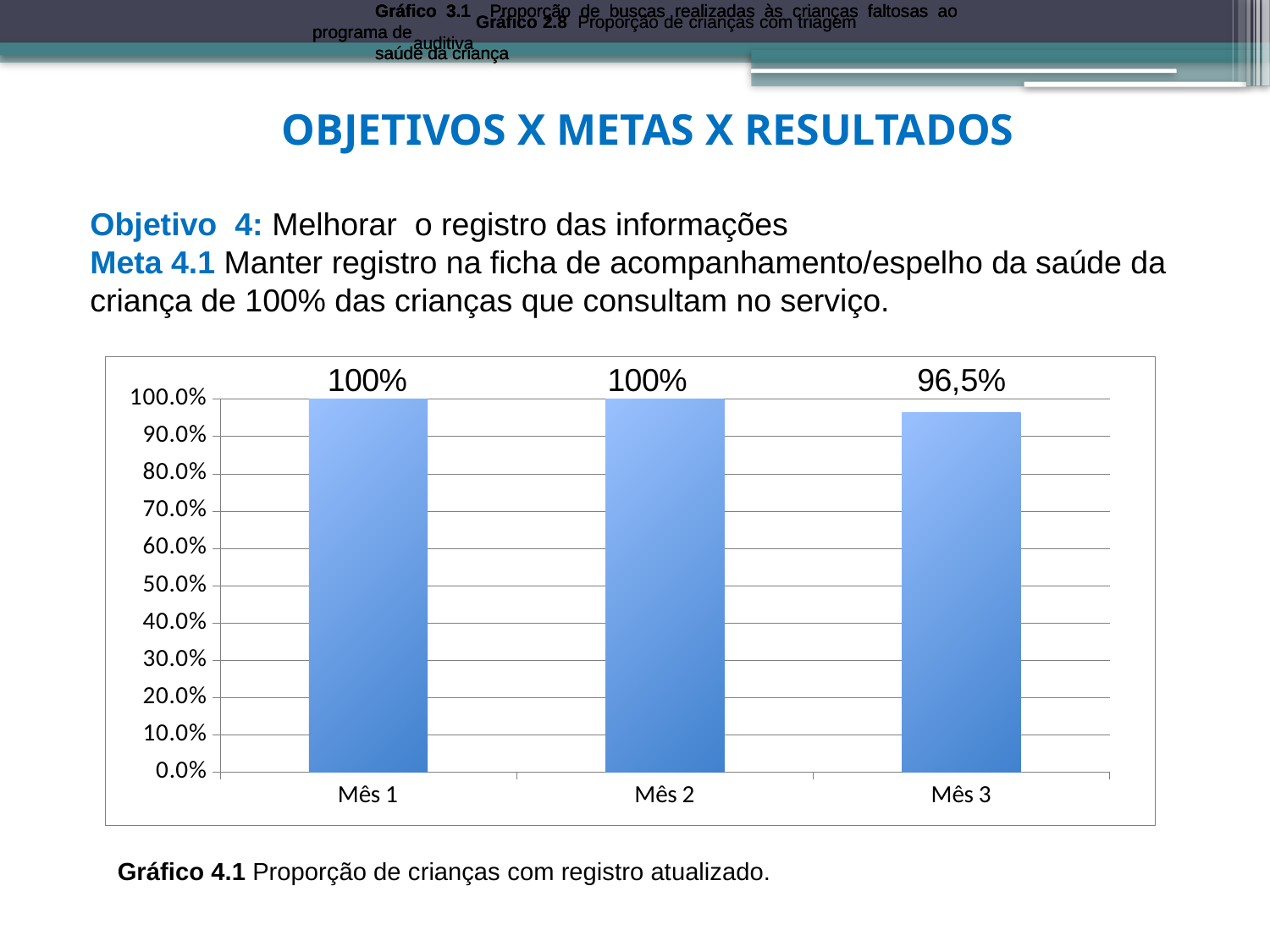
What kind of chart is shown on the slide? bar chart Do the values rise, fall or stay the same from Mês 1 to Mês 2? stay the same What is the value for Mês 1? 100% Which month has the lowest value? Mês 3 What is the value for Mês 2? 100% What is the value for Mês 3? 96,5% What is the caption of the chart given below it? Gráfico 4.1 Proporção de crianças com registro atualizado. What is the difference between the values for Mês 1 and Mês 3? 3,5% Do the values rise or fall from Mês 2 to Mês 3? fall How many categories are shown on the x axis? 3 Is the value for Mês 3 greater or less than 90.0%? greater Which is larger, the value for Mês 2 or the value for Mês 3? Mês 2